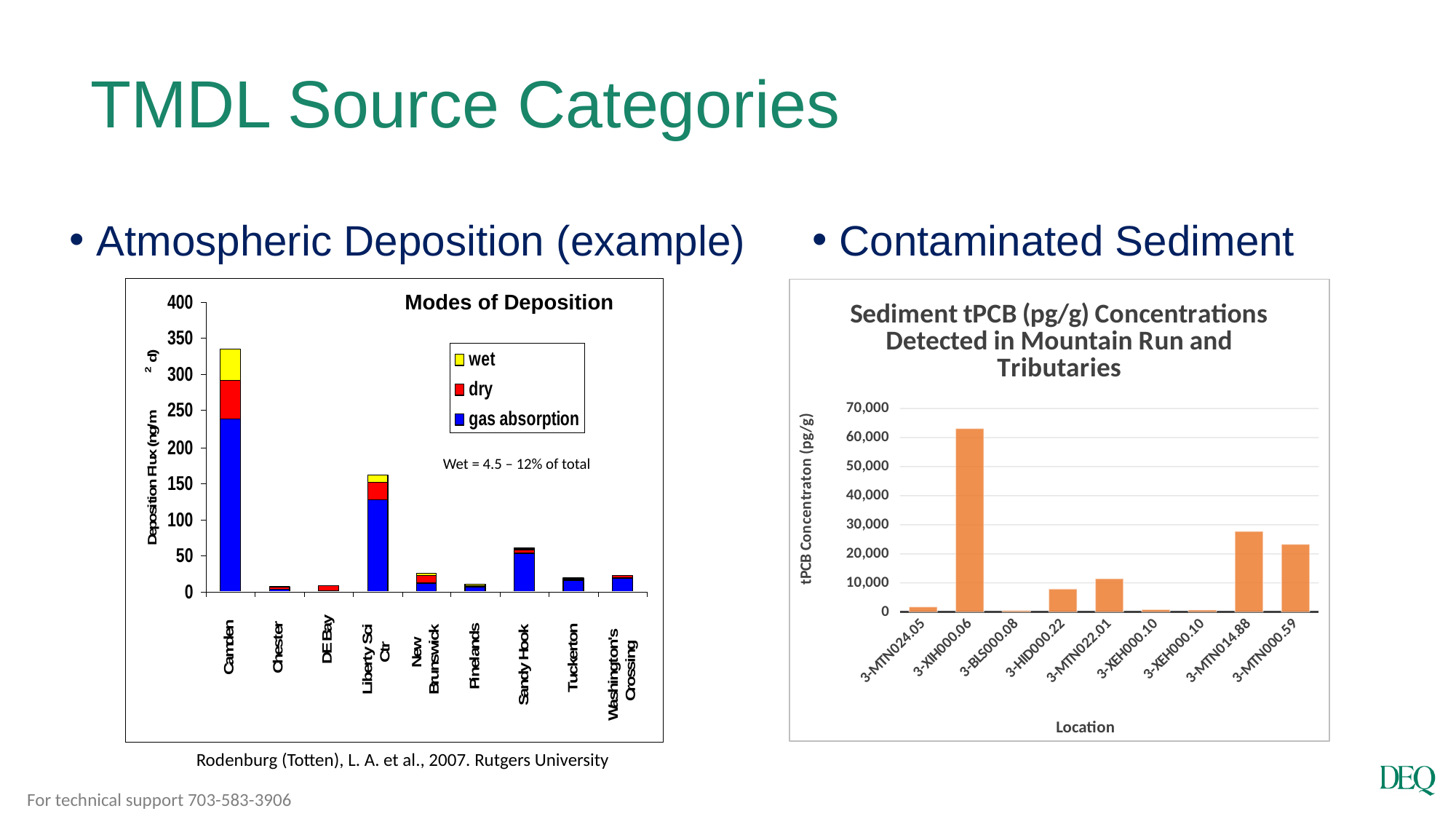
In the Sediment tPCB Concentrations chart, which location has the highest tPCB concentration? 3-XIH000.06 What kind of chart is the Sediment tPCB Concentrations chart? Bar chart In the Modes of Deposition chart, is the total value for Sandy Hook greater or less than 100? less In the Modes of Deposition chart, which site has the highest total deposition flux? Camden In the Modes of Deposition chart, how many series does the legend list? 3 In the Modes of Deposition chart, is the total value for Camden greater or less than 300? greater In the Modes of Deposition chart, which colour represents gas absorption in the legend? Blue In the Sediment tPCB Concentrations chart, is the value for 3-XIH000.06 greater or less than 60,000? greater In the Modes of Deposition chart, how many sites are shown on the x axis? 9 In the Sediment tPCB Concentrations chart, which has the larger value, 3-MTN014.88 or 3-MTN000.59? 3-MTN014.88 In the Sediment tPCB Concentrations chart, how many locations are shown on the x axis? 9 In the Modes of Deposition chart, which has the larger total deposition flux, Camden or Liberty Sci Ctr? Camden